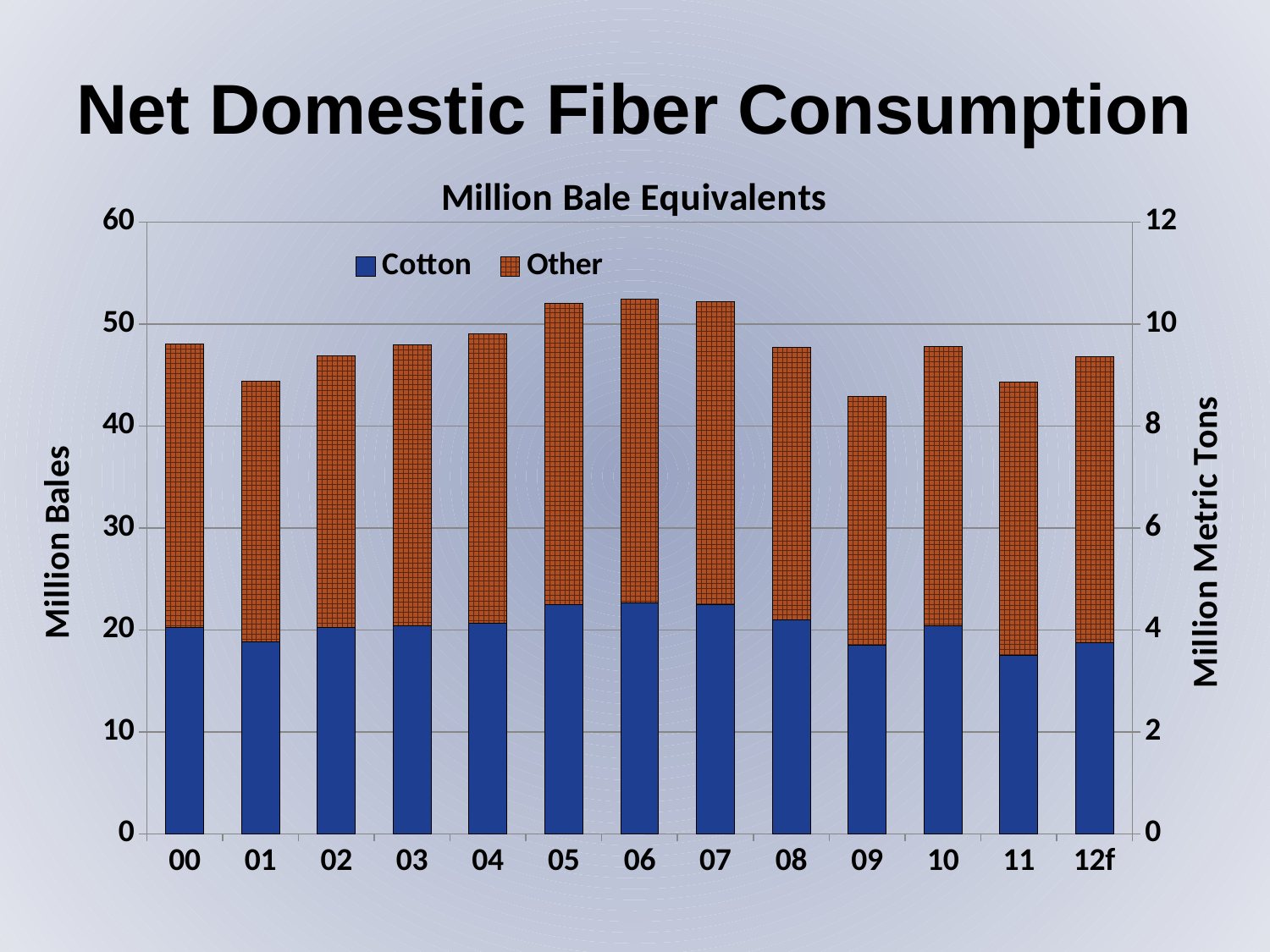
Which year has the lowest total fiber consumption? 09 Is the total bar for 09 greater or less than 50 million bales? less Is the Cotton value for 11 greater or less than 20 million bales? less Which year has the lowest Cotton value? 11 How many years (categories) are shown along the x axis? 13 Which year has the larger Cotton value, 05 or 11? 05 What is the label of the right-hand vertical axis? Million Metric Tons How many series does the legend list? 2 What kind of chart is shown on the slide? Stacked bar chart What are the two series named in the legend? Cotton and Other Is the total bar for 06 greater or less than 50 million bales? greater Which year has the larger total fiber consumption, 06 or 09? 06